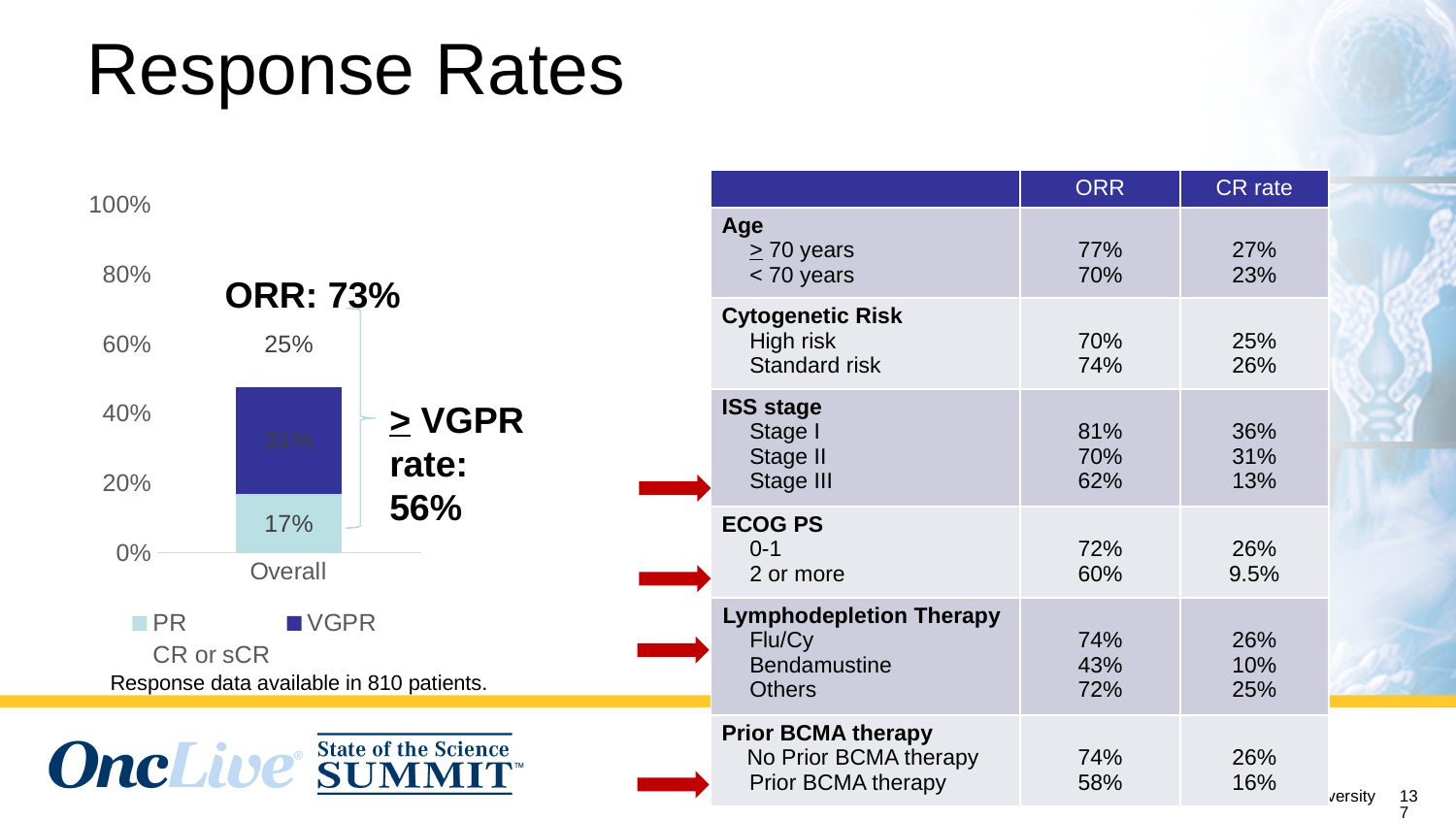
What is the PR value for the Overall bar? 17% What kind of chart is shown on the left of the slide? bar chart Which response category has the smallest value in the Overall bar? PR Which is larger in the Overall bar, the PR value or the CR or sCR value? CR or sCR What ≥ VGPR rate is annotated next to the bar chart? 56% What value is shown for CR or sCR in the Overall bar? 25% How many categories are shown on the x axis of the bar chart? 1 What is the difference between the VGPR value and the PR value in the Overall bar? 14% How many series does the chart legend list? 3 What is the total of the PR, VGPR and CR or sCR values in the Overall bar? 73% What is the VGPR value for the Overall bar? 31% Which response category has the largest value in the Overall bar? VGPR